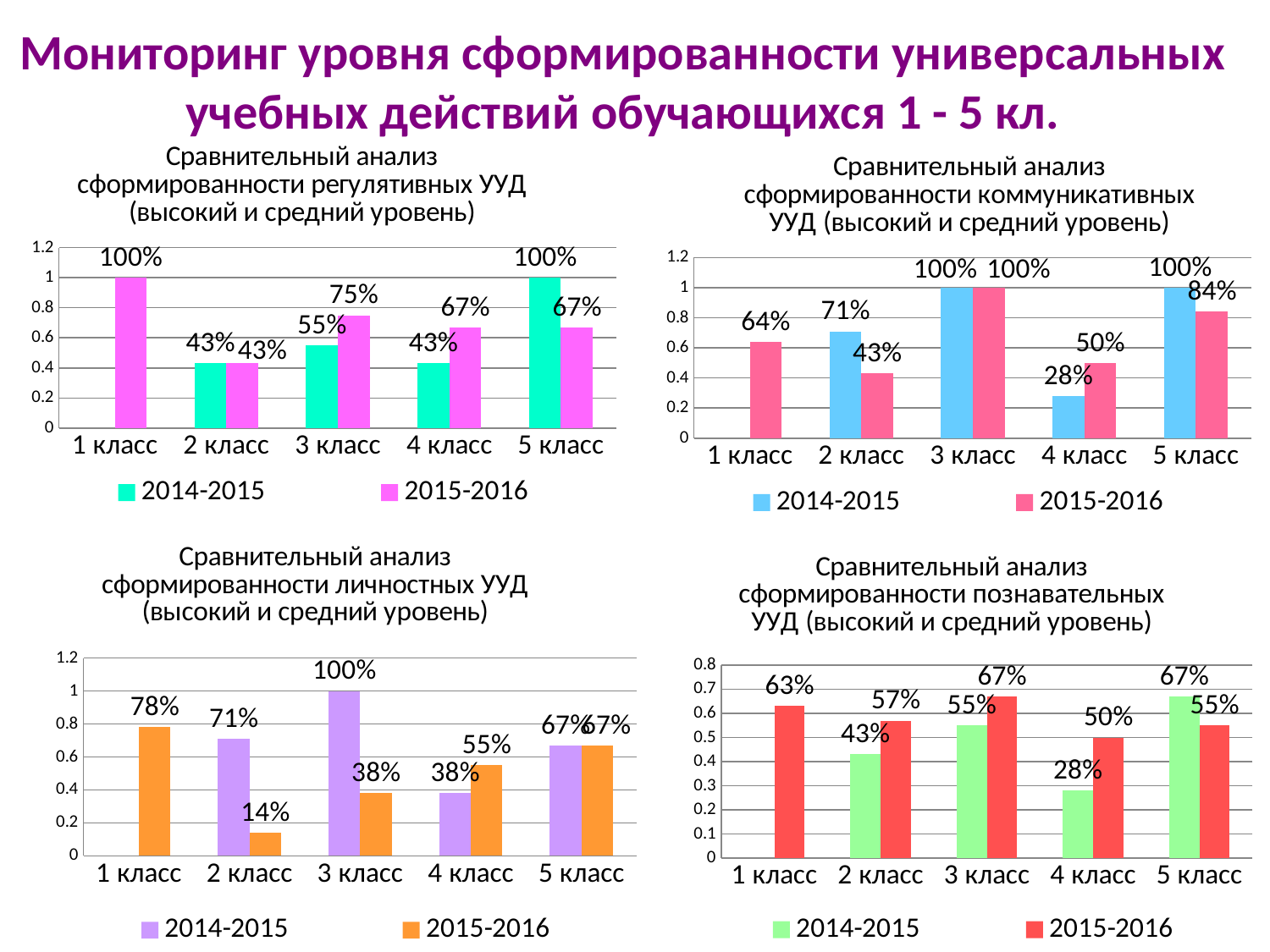
How many series does the legend of the top-left chart (регулятивных УУД) list? 2 On the top-right chart (коммуникативных УУД), what is the value for 4 класс in the 2014-2015 series? 28% On the top-left chart (регулятивных УУД), what is the value for 3 класс in the 2015-2016 series? 75% On the top-left chart (регулятивных УУД), what is the value for 5 класс in the 2014-2015 series? 100% On the bottom-right chart (познавательных УУД), what is the difference between the 2015-2016 and 2014-2015 values for 2 класс? 14% On the bottom-right chart (познавательных УУД), which is larger for 4 класс: the 2014-2015 value or the 2015-2016 value? 2015-2016 On the bottom-right chart (познавательных УУД), what is the value for 1 класс in the 2015-2016 series? 63% On the bottom-left chart (личностных УУД), which class has the highest value in the 2014-2015 series? 3 класс What type of chart is the top-right chart (коммуникативных УУД)? Bar chart On the top-right chart (коммуникативных УУД), what is the difference between the 2014-2015 and 2015-2016 values for 2 класс? 28% On the bottom-left chart (личностных УУД), which class has the lowest value in the 2015-2016 series? 2 класс How many class categories are shown on the x axis of the bottom-left chart (личностных УУД)? 5